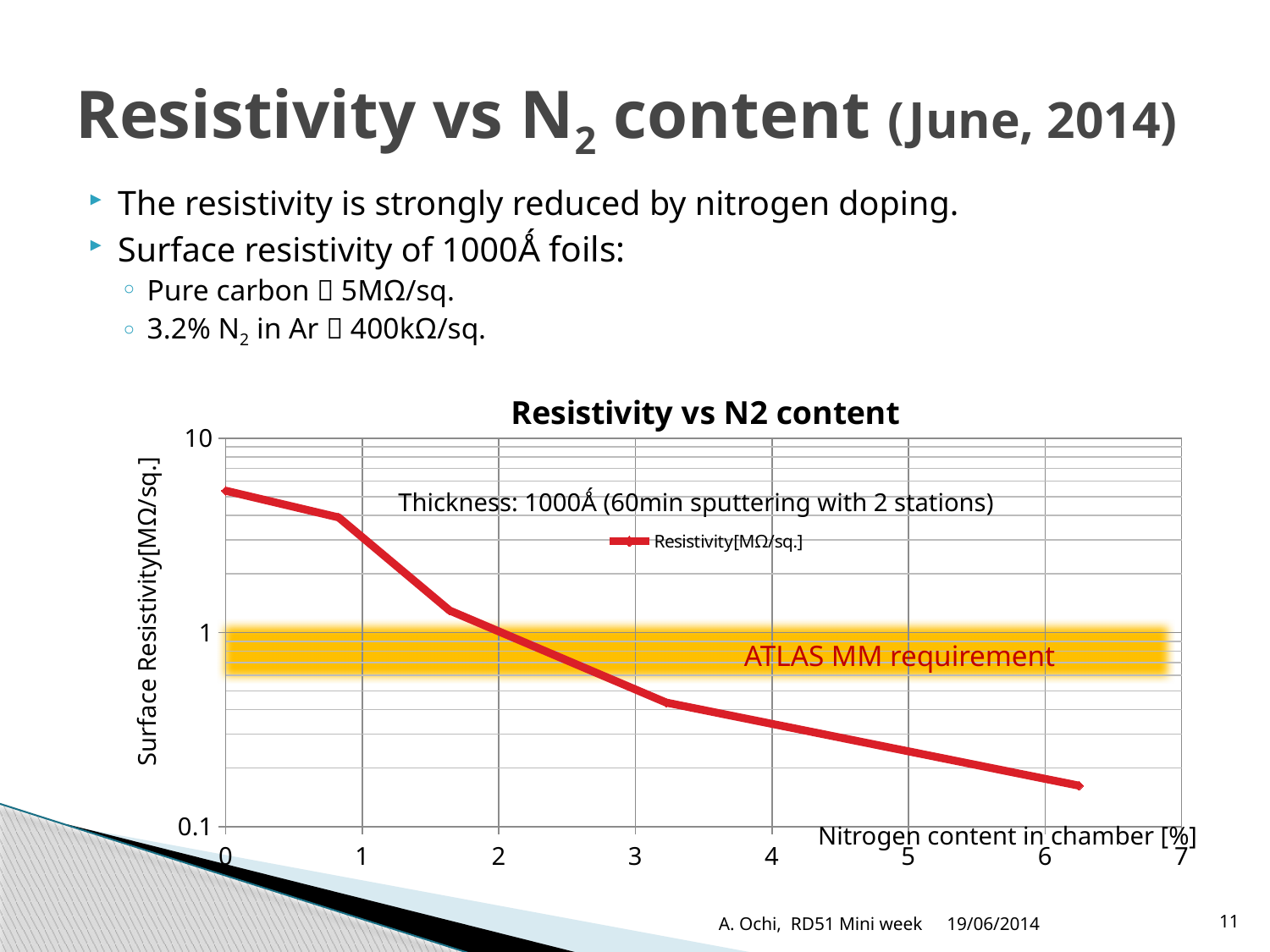
Is the surface resistivity at 0% nitrogen content greater or less than 10 MΩ/sq.? less What is the label of the x axis? Nitrogen content in chamber [%] What kind of chart is shown on the slide? line chart What is the legend entry for the plotted series? Resistivity[MΩ/sq.] How many data points are plotted on the line? 5 Is the surface resistivity at 0% nitrogen content greater or less than 1 MΩ/sq.? greater Which data point has the highest surface resistivity, the one at 0% nitrogen or the rightmost one? the one at 0% nitrogen Is the surface resistivity at the rightmost data point (around 6% nitrogen) greater or less than 1 MΩ/sq.? less What is the title of the chart? Resistivity vs N2 content Does the surface resistivity rise or fall as nitrogen content increases? fall How many series does the chart legend list? 1